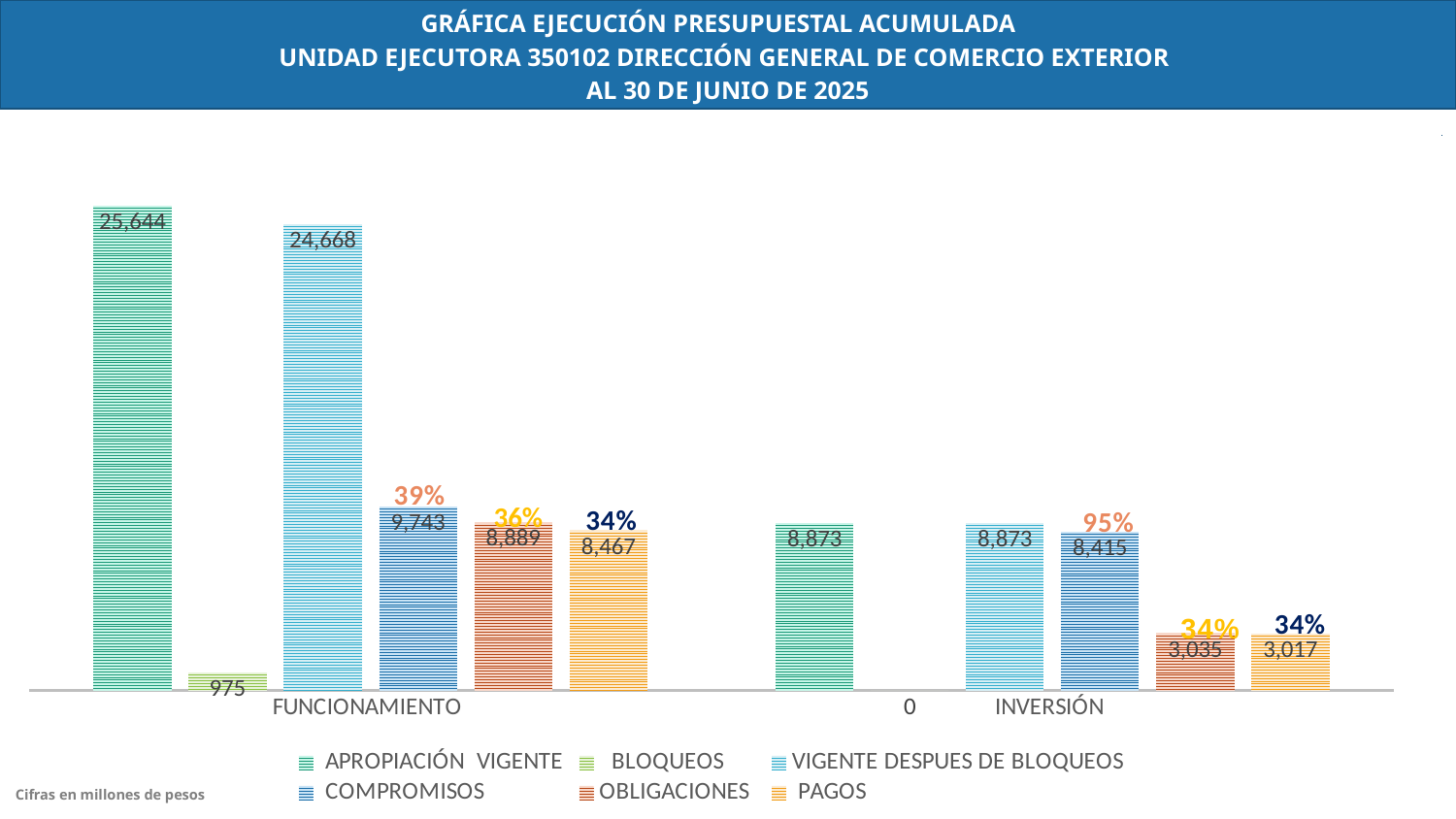
What is the COMPROMISOS value for INVERSIÓN? 8,415 Which series has the lowest value for FUNCIONAMIENTO? BLOQUEOS What kind of chart is shown on the slide? Bar chart How many series does the legend list? 6 What is the difference between APROPIACIÓN VIGENTE and VIGENTE DESPUES DE BLOQUEOS for FUNCIONAMIENTO? 976 Which series has the highest value for FUNCIONAMIENTO? APROPIACIÓN VIGENTE In what units are the figures on the chart expressed, according to the note at the bottom left? Millones de pesos What is the APROPIACIÓN VIGENTE value for FUNCIONAMIENTO? 25,644 What is the BLOQUEOS value for FUNCIONAMIENTO? 975 Which is larger for INVERSIÓN: OBLIGACIONES or PAGOS? OBLIGACIONES What is the PAGOS value for INVERSIÓN? 3,017 What percentage is shown above the COMPROMISOS bar for INVERSIÓN? 95%